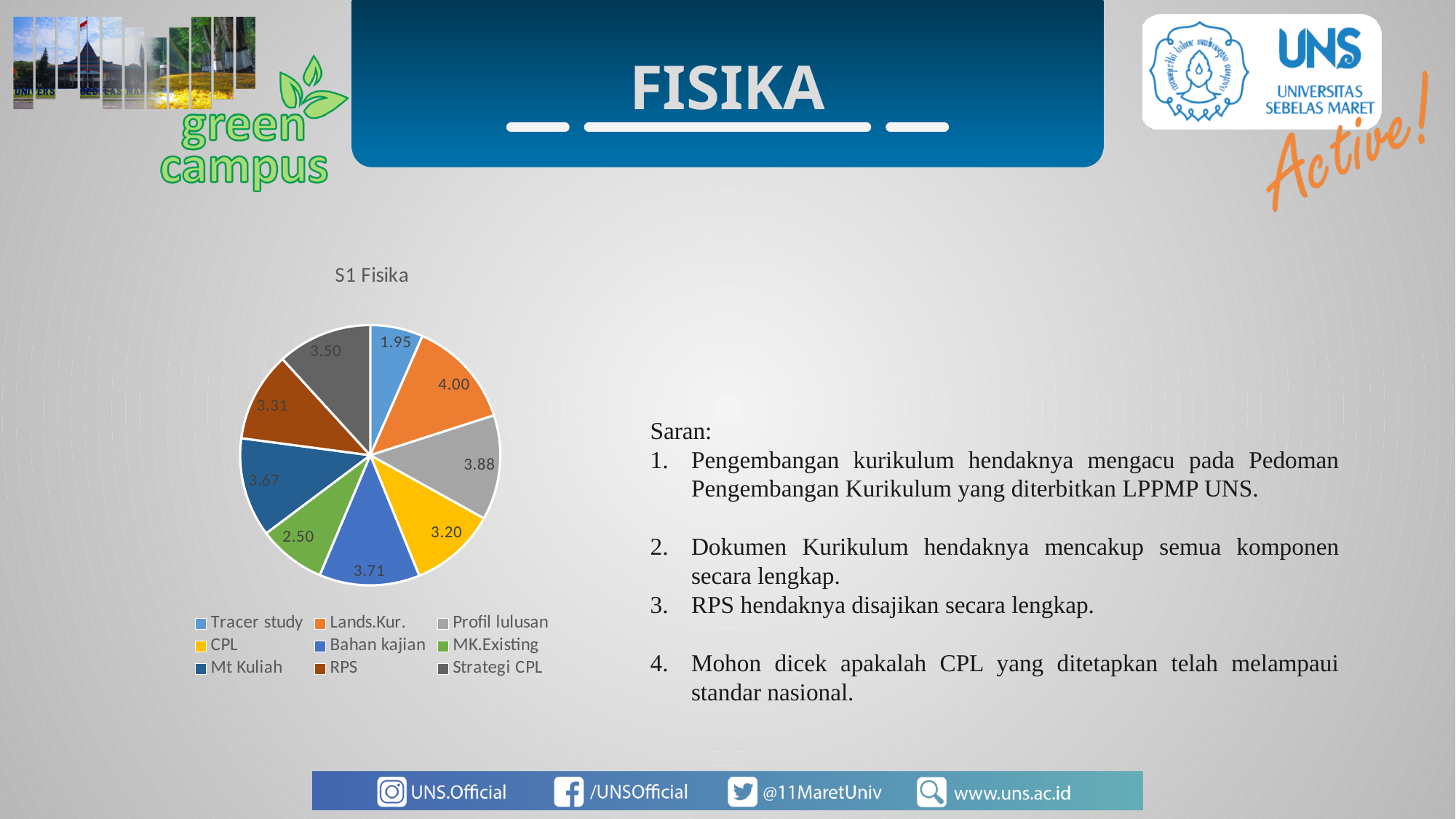
Which is larger, the value for MK.Existing or the value for RPS? RPS Which category has the lowest value in the pie chart? Tracer study What is the value for Strategi CPL in the pie chart? 3.50 What is the value for Lands.Kur. in the pie chart? 4.00 What type of chart is shown on the slide? Pie chart Which category has the highest value in the pie chart? Lands.Kur. How many slices does the pie chart have? 9 What is the value for Bahan kajian in the pie chart? 3.71 What colour is the Mt Kuliah slice in the pie chart? Dark blue What is the title of the chart? S1 Fisika What is the value for Tracer study in the pie chart? 1.95 What is the difference between the values for Profil lulusan and CPL? 0.68